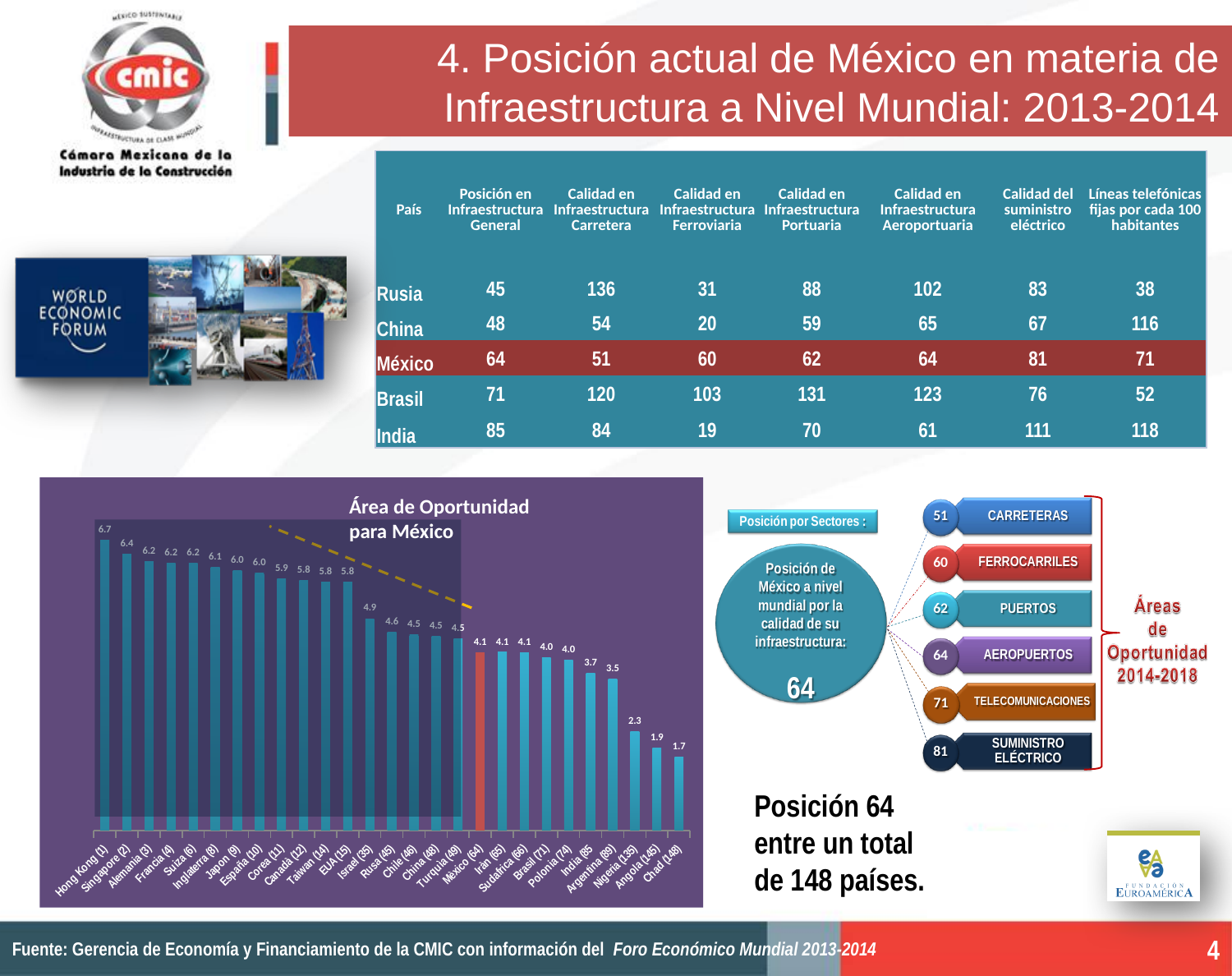
How many countries are plotted in the bar chart? 27 What kind of chart is shown at the bottom left of the slide? bar chart Which country has the highest bar in the chart? Hong Kong (1) Which has a larger value in the bar chart, Rusia (45) or India (85)? Rusia (45) Which country has the lowest bar in the chart? Chad (148) Which country's bar is highlighted in a different colour (red) in the bar chart? México (64) What is the value shown for México (64) in the bar chart? 4.1 What is the value shown for Israel (35) in the bar chart? 4.9 What is the value shown for Hong Kong (1) in the bar chart? 6.7 What is the value shown for Chad (148) in the bar chart? 1.7 Do the bar values rise or fall from left to right across the chart? fall What is the difference between the values for Hong Kong (1) and México (64) in the bar chart? 2.6